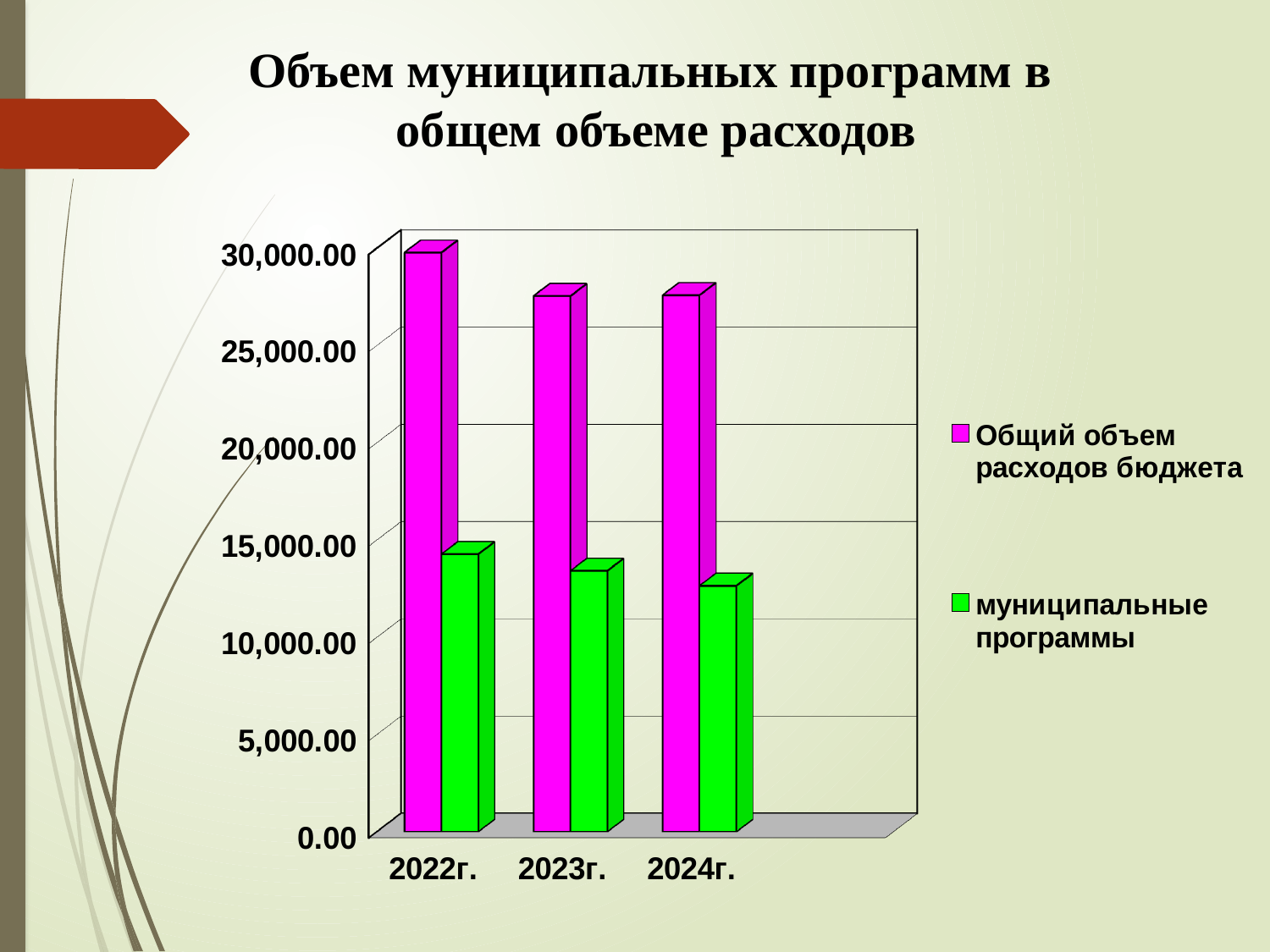
What kind of chart is shown on the slide? bar chart Is the value for 'Общий объем расходов бюджета' in 2023г. greater or less than 30,000.00? less What is the title of the chart? Объем муниципальных программ в общем объеме расходов Is the value for 'Общий объем расходов бюджета' in 2022г. greater or less than 25,000.00? greater Which colour represents the series 'муниципальные программы'? green In which year is the value for 'муниципальные программы' highest? 2022г. How many series does the legend list? 2 In which year is the value for 'муниципальные программы' lowest? 2024г. Is the value for 'муниципальные программы' in 2024г. greater or less than 15,000.00? less How many years are shown on the x axis? 3 Do the values for 'муниципальные программы' rise or fall from 2022г. to 2024г.? fall In which year is the value for 'Общий объем расходов бюджета' highest? 2022г.